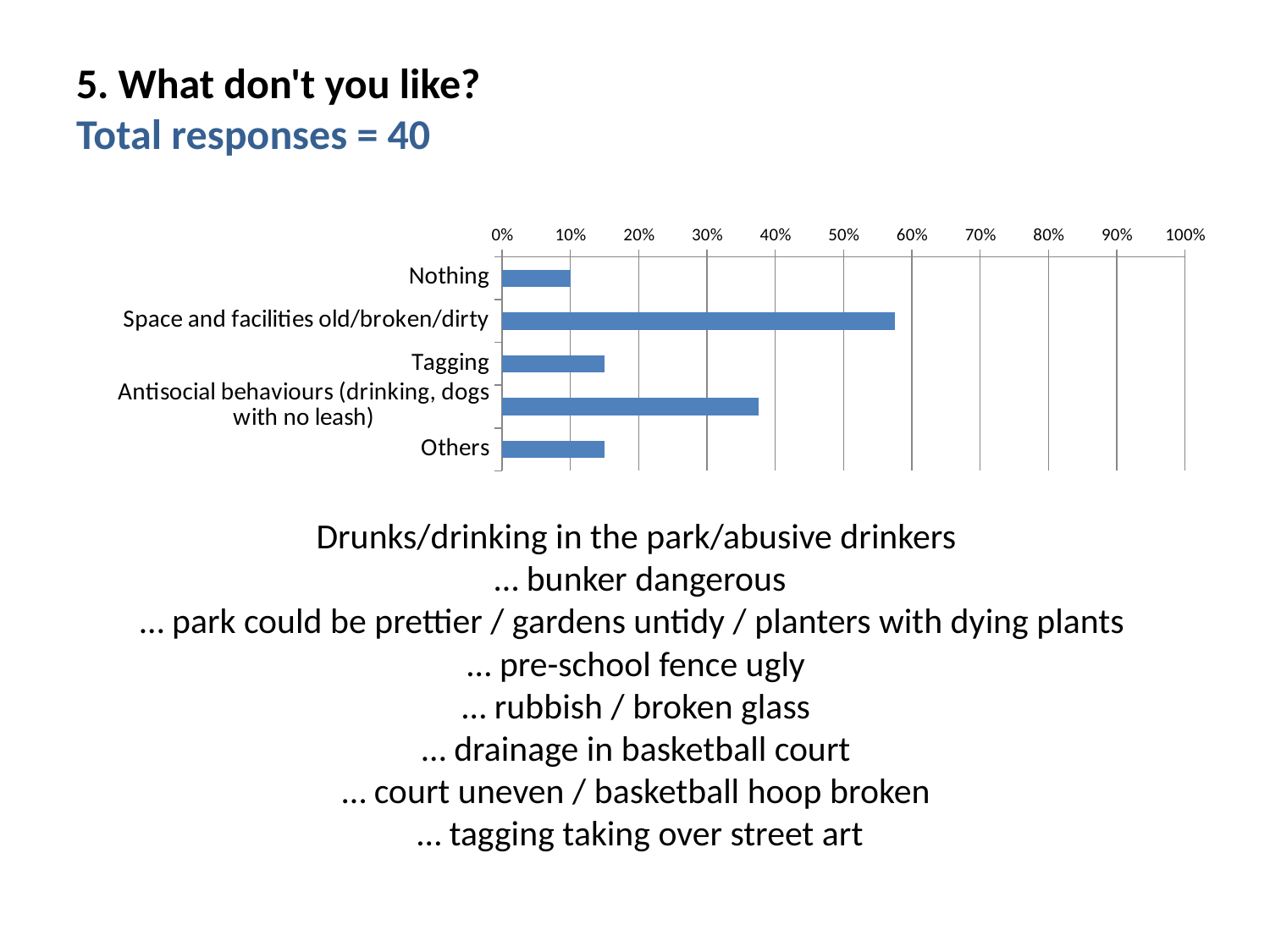
How many categories are shown in the chart? 5 What is the maximum value shown on the chart's percentage axis? 100% Which is larger, the value for Tagging or the value for Antisocial behaviours (drinking, dogs with no leash)? Antisocial behaviours (drinking, dogs with no leash) Is the value for Tagging greater or less than 20%? less Is the value for Space and facilities old/broken/dirty greater or less than 50%? greater Which category has the highest value in the chart? Space and facilities old/broken/dirty Which is larger, the value for Nothing or the value for Space and facilities old/broken/dirty? Space and facilities old/broken/dirty Which category has the lowest value in the chart? Nothing Is the value for Antisocial behaviours (drinking, dogs with no leash) greater or less than 40%? less What kind of chart is shown on the slide? bar chart